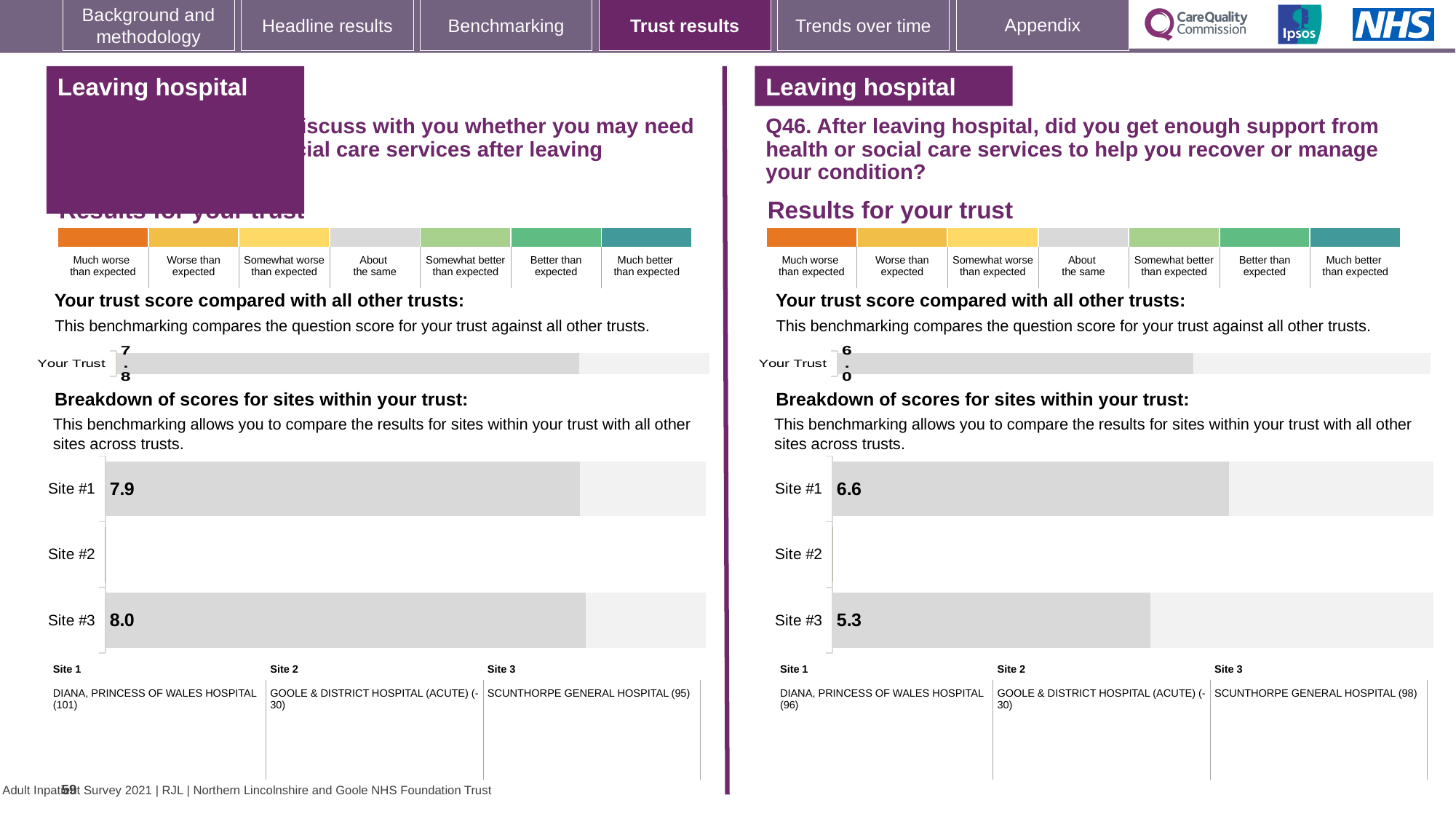
On the left-hand chart, what is the score for Site #3 in the breakdown of sites? 8.0 On the left-hand chart, what is the score shown for Your Trust? 7.8 What kind of chart is used to show the breakdown of scores for sites on the right-hand side (Q46)? Bar chart On the left-hand chart, which site has the highest score in the breakdown of sites? Site #3 On the right-hand chart (Q46), what is the score shown for Your Trust? 6.0 On the left-hand chart, what is the score for Site #1 in the breakdown of sites? 7.9 On the right-hand chart (Q46), what is the score for Site #3 in the breakdown of sites? 5.3 On the right-hand chart (Q46), which site has the higher score, Site #1 or Site #3? Site #1 On the left-hand chart, what is the difference between the scores for Site #3 and Site #1? 0.1 On the right-hand chart (Q46), what is the difference between the scores for Site #1 and Site #3? 1.3 On the right-hand chart (Q46), what is the score for Site #1 in the breakdown of sites? 6.6 How many sites are listed in the breakdown of scores on the right-hand chart (Q46)? 3